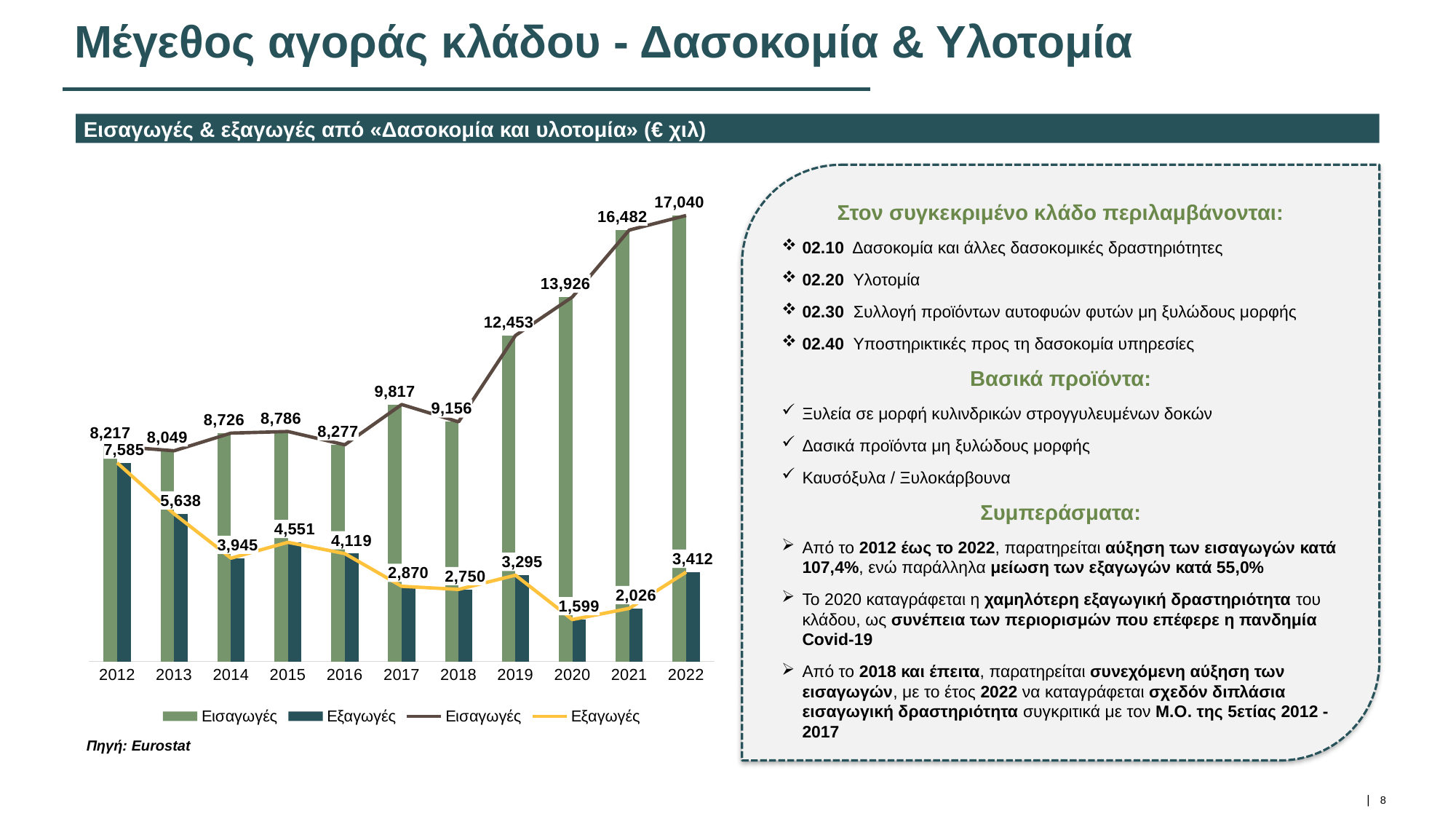
What is the value of Εισαγωγές in 2017? 9,817 In which year are Εξαγωγές (exports) lowest? 2020 How many entries does the chart legend list? 4 What is the value of Εξαγωγές (exports) in 2020? 1,599 What is the value of Εισαγωγές (imports) in 2022? 17,040 Which is larger in 2019, Εισαγωγές or Εξαγωγές? Εισαγωγές Do Εισαγωγές (imports) generally rise or fall from 2018 to 2022? Rise What is the difference between Εισαγωγές and Εξαγωγές in 2012? 632 How many years are shown on the x axis of the chart? 11 What kind of chart is shown on the slide? Combined bar and line chart By how much did Εισαγωγές increase from 2021 to 2022? 558 In which year are Εισαγωγές (imports) highest? 2022